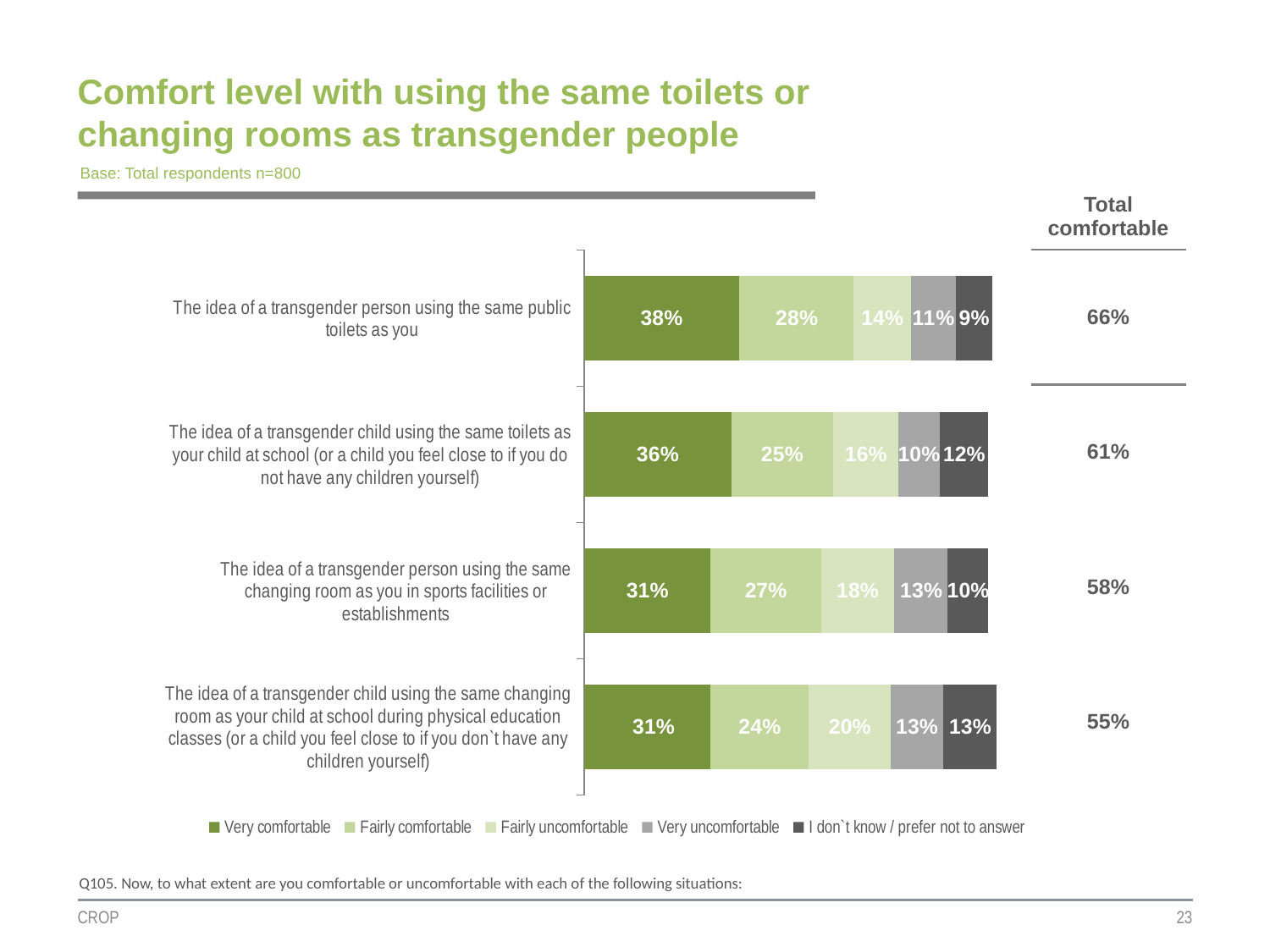
What is the difference between the "Total comfortable" percentage for the public toilets situation and the changing room during physical education classes situation? 11 percentage points How many series does the legend list? 5 What is the "Total comfortable" figure for the idea of a transgender person using the same changing room as you in sports facilities or establishments? 58% What percentage of respondents are "Very comfortable" with the idea of a transgender person using the same public toilets as you? 38% Which situation has the highest "Total comfortable" percentage? The idea of a transgender person using the same public toilets as you How many situations (categories) are shown in the chart? 4 Which is larger: the "Fairly uncomfortable" share for the sports facilities changing room situation or for the public toilets situation? Sports facilities changing room (18%) What is the base (number of respondents) stated on the slide? Total respondents n=800 What percentage of respondents answered "I don`t know / prefer not to answer" for the idea of a transgender child using the same toilets as your child at school? 12% What kind of chart is shown on the slide? Stacked horizontal bar chart What percentage of respondents are "Fairly comfortable" with the idea of a transgender child using the same changing room as your child at school during physical education classes? 24%